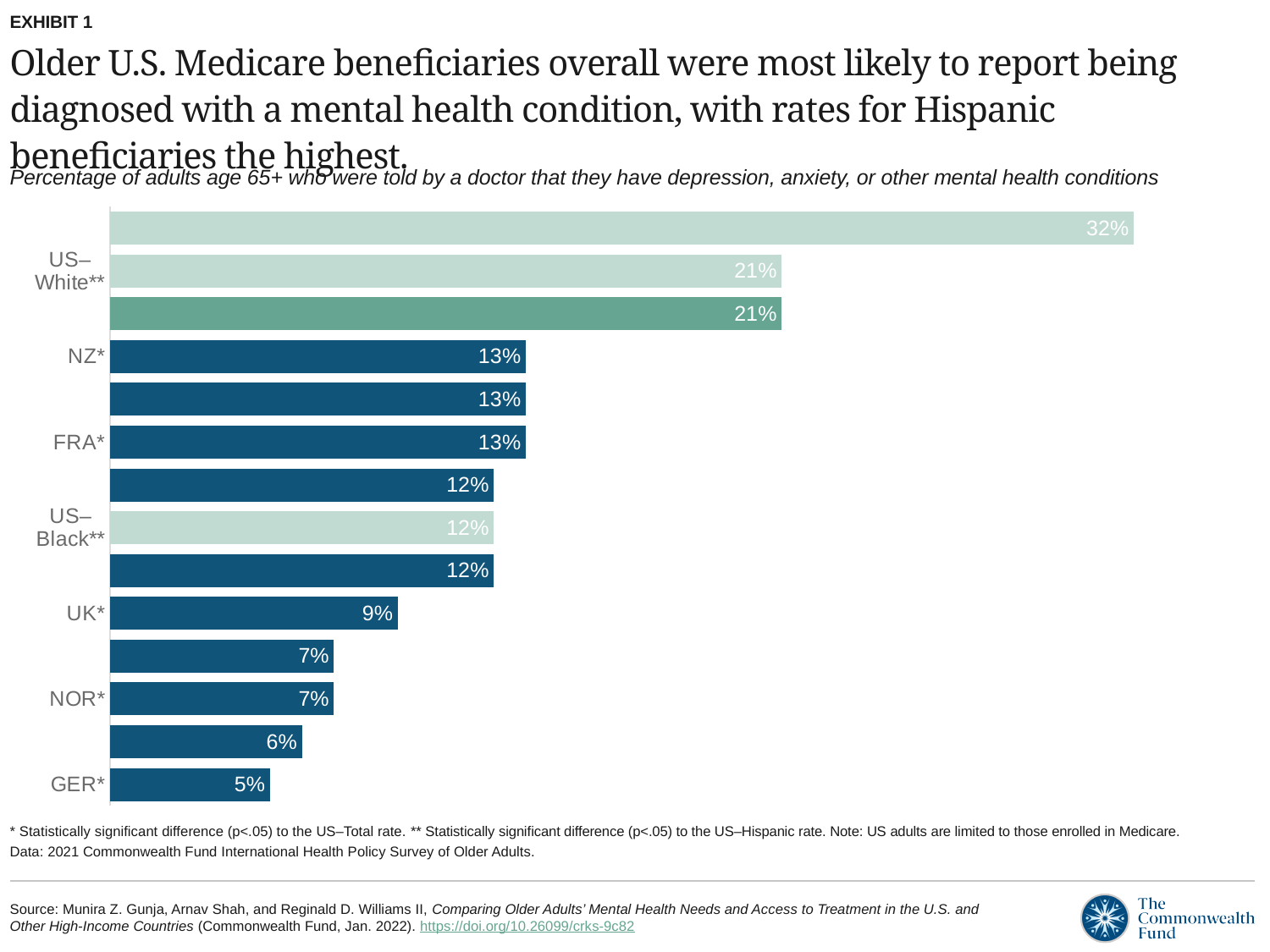
What is the value for US–Black**? 12% What is the value for US–White**? 21% What is the value for NOR*? 7% What is the difference between the values for US–White** and NZ*? 8 percentage points What is the value for UK*? 9% What is the value for FRA*? 13% Which labeled category has the lowest value? GER* What is the value for NZ*? 13% Which is larger, the value for UK* or the value for NOR*? UK* What is the value for GER*? 5% What is the highest value shown on the chart? 32% What kind of chart is shown on the slide? bar chart